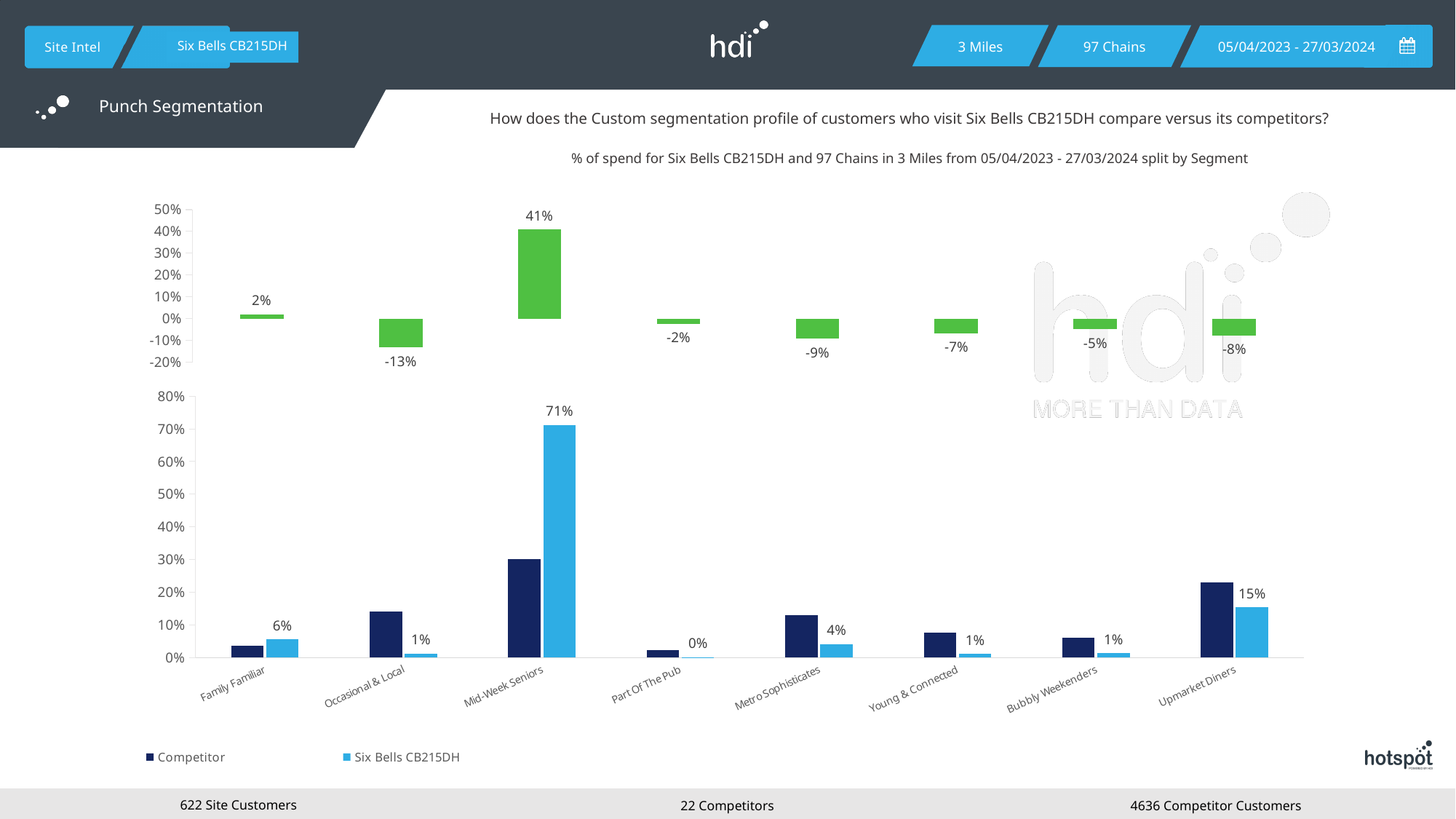
How many segments are shown on the x axis of the bottom chart? 8 In the bottom chart, which segment has the highest Six Bells CB215DH value? Mid-Week Seniors In the bottom chart, is the Competitor value for Upmarket Diners greater or less than 20%? greater In the bottom chart, is the Competitor value for Mid-Week Seniors greater or less than 40%? less In the bottom chart, what is the Six Bells CB215DH value for Upmarket Diners? 15% In the bottom chart, what is the Six Bells CB215DH value for Mid-Week Seniors? 71% In the top chart, what is the difference between the values for Mid-Week Seniors and Metro Sophisticates? 50 percentage points How many series does the legend of the bottom chart list? 2 In the top chart, what is the value for Occasional & Local? -13% In the bottom chart, which is larger for Occasional & Local: the Competitor value or the Six Bells CB215DH value? Competitor In the top chart, what is the value for Mid-Week Seniors? 41% In the top chart, which segment has the lowest value? Occasional & Local